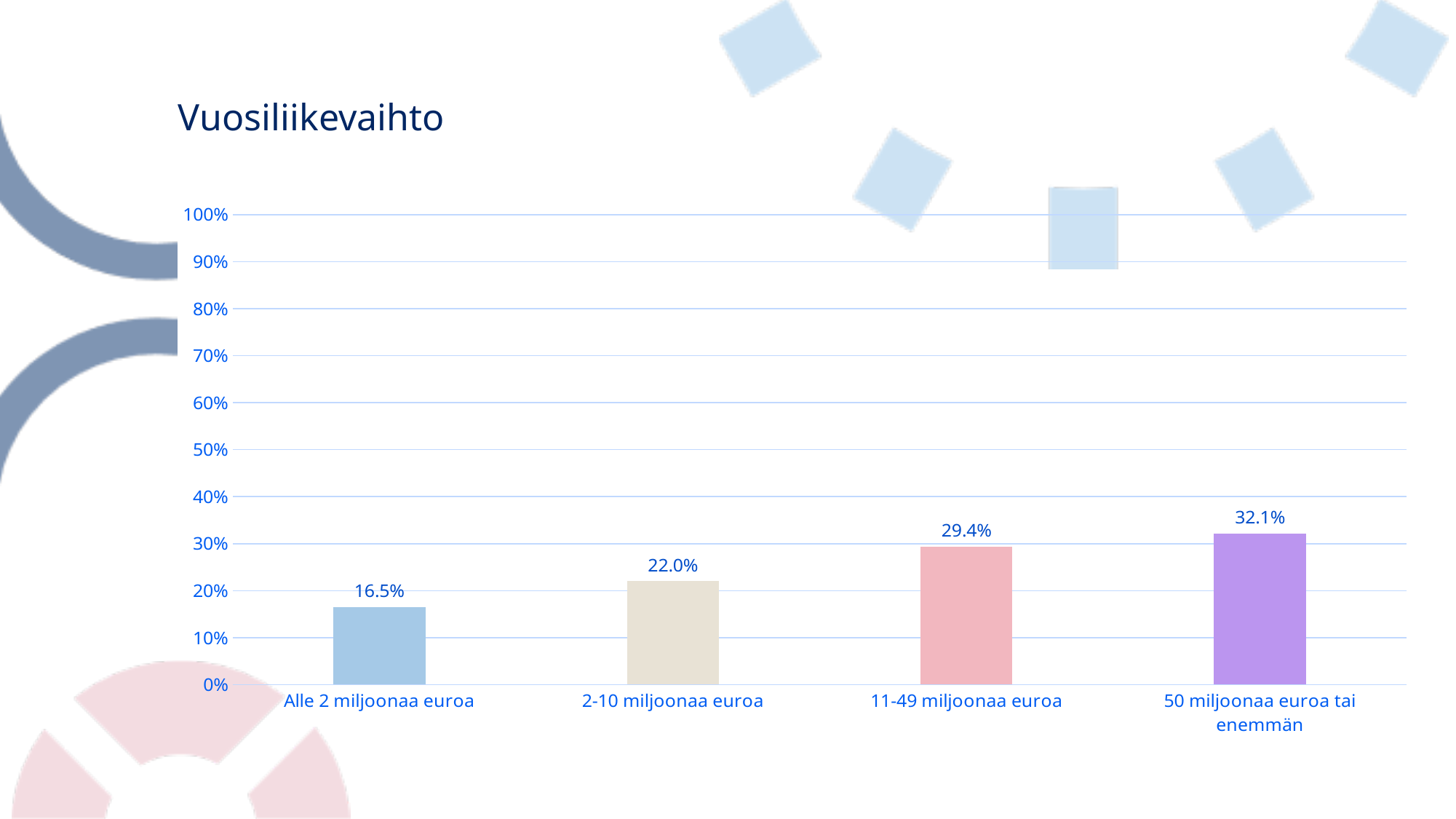
What is the value for '2-10 miljoonaa euroa'? 22.0% Do the values rise or fall from left to right along the x axis? rise Which category has the highest value? 50 miljoonaa euroa tai enemmän Which is larger, the value for '2-10 miljoonaa euroa' or '11-49 miljoonaa euroa'? 11-49 miljoonaa euroa Which category has the lowest value? Alle 2 miljoonaa euroa Is the value for '11-49 miljoonaa euroa' greater or less than 30%? less How many categories are shown on the x axis? 4 What is the value for '50 miljoonaa euroa tai enemmän'? 32.1% What is the value for '11-49 miljoonaa euroa'? 29.4% What is the value for 'Alle 2 miljoonaa euroa'? 16.5% What kind of chart is shown on the slide? bar chart What is the difference between the values for '50 miljoonaa euroa tai enemmän' and 'Alle 2 miljoonaa euroa'? 15.6%